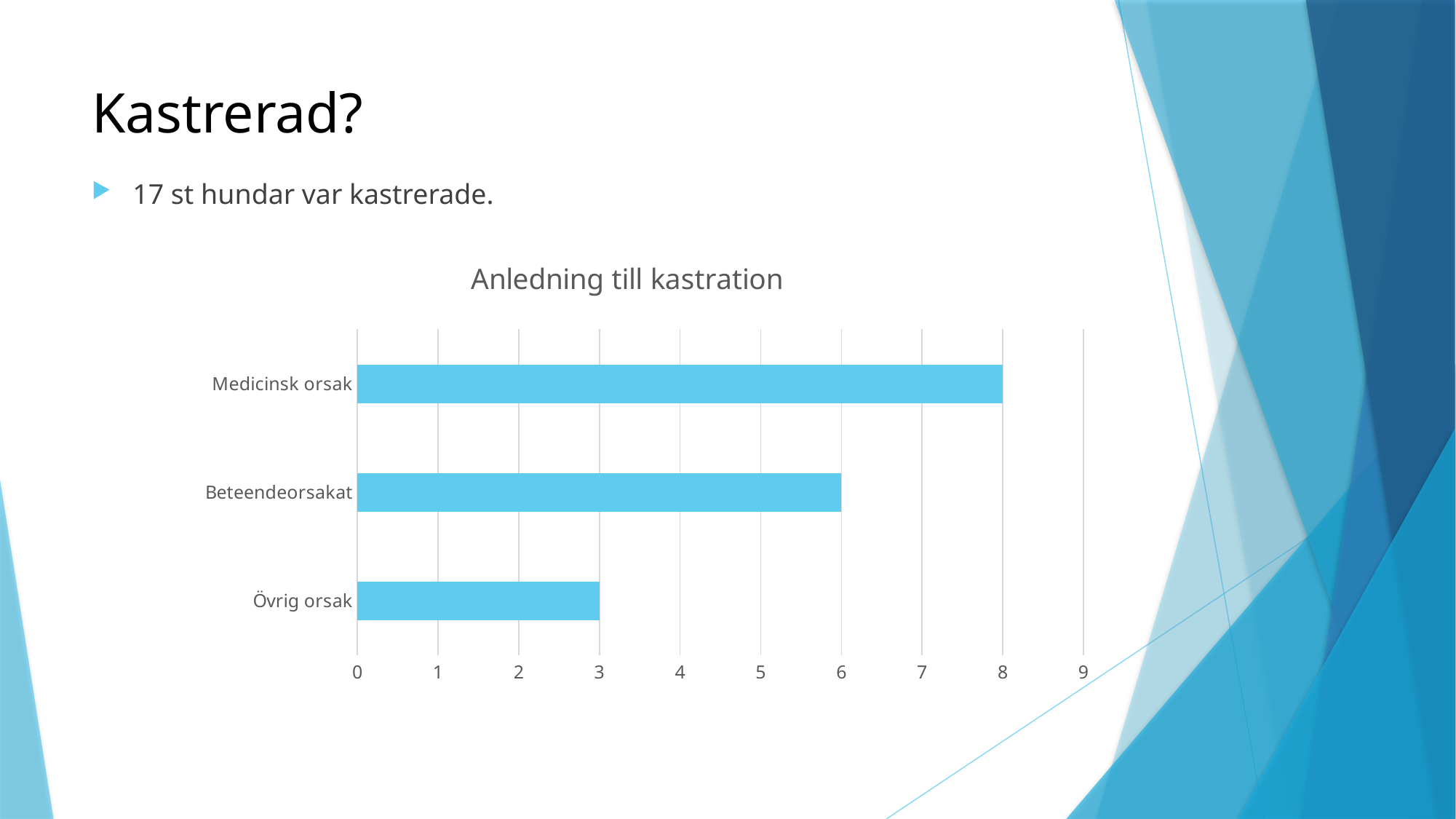
What is the value for Beteendeorsakat? 6 What is the title of the chart? Anledning till kastration What is the difference between the values for Medicinsk orsak and Beteendeorsakat? 2 What is the value for Medicinsk orsak? 8 Which category has the highest value? Medicinsk orsak What is the value for Övrig orsak? 3 What kind of chart is shown on the slide? bar chart Which is larger, the value for Beteendeorsakat or the value for Övrig orsak? Beteendeorsakat Is the value for Beteendeorsakat greater or less than 5? greater Which category has the lowest value? Övrig orsak How many categories are shown in the chart? 3 What is the difference between the values for Medicinsk orsak and Övrig orsak? 5